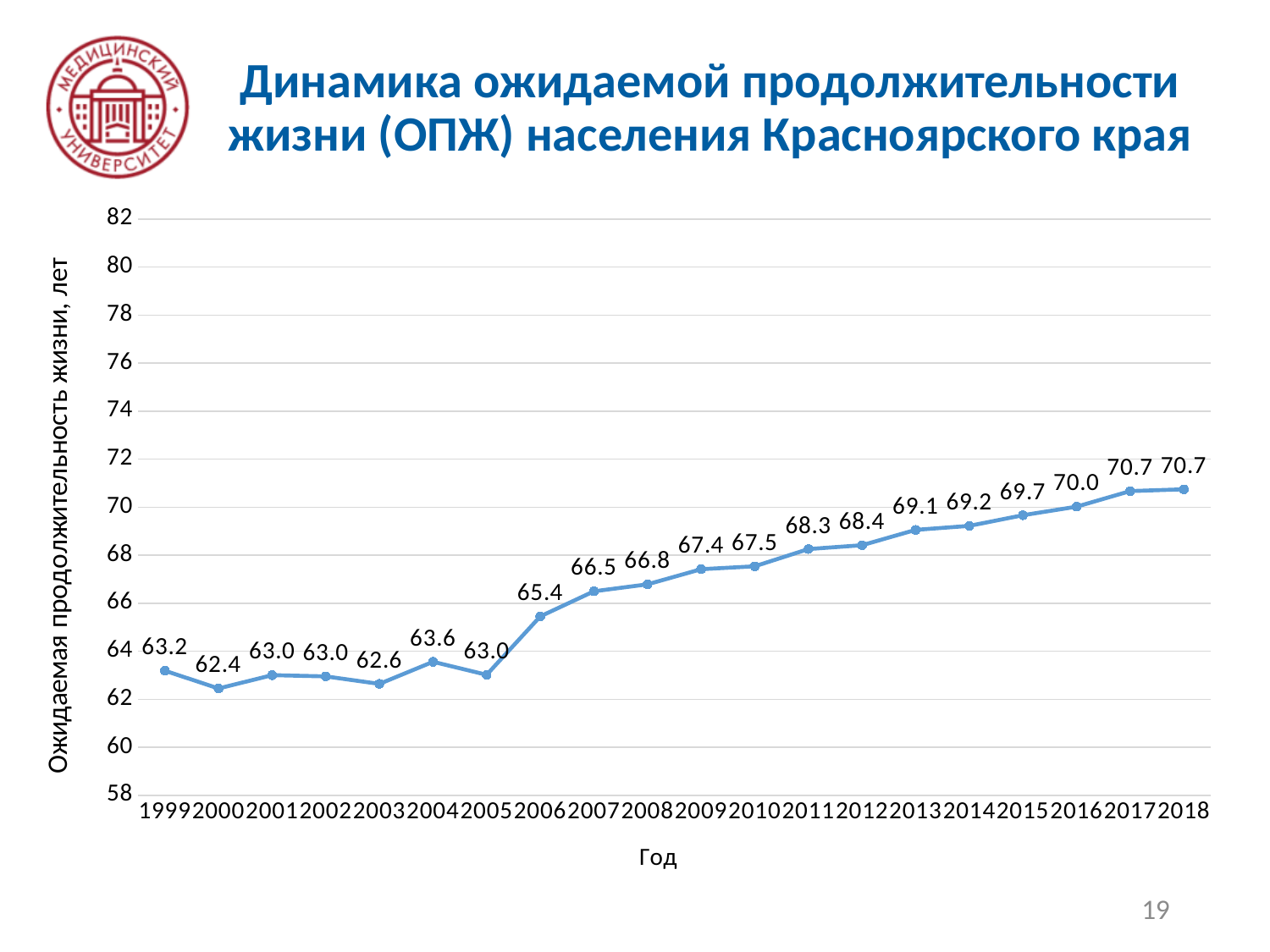
Is the life expectancy value for 2011 greater or less than 68? greater How many years are plotted on the chart? 20 What is the difference between the life expectancy in 2018 and in 1999? 7.5 What kind of chart is shown on the slide? line chart What is the label of the x axis? Год In which year is the life expectancy lowest? 2000 What is the difference between the life expectancy in 2006 and in 2005? 2.4 What is the highest life expectancy value shown on the chart? 70.7 Which year has a higher life expectancy, 2004 or 2005? 2004 What is the life expectancy value shown for 2006? 65.4 What is the life expectancy value shown for 1999? 63.2 What is the life expectancy value shown for 2013? 69.1